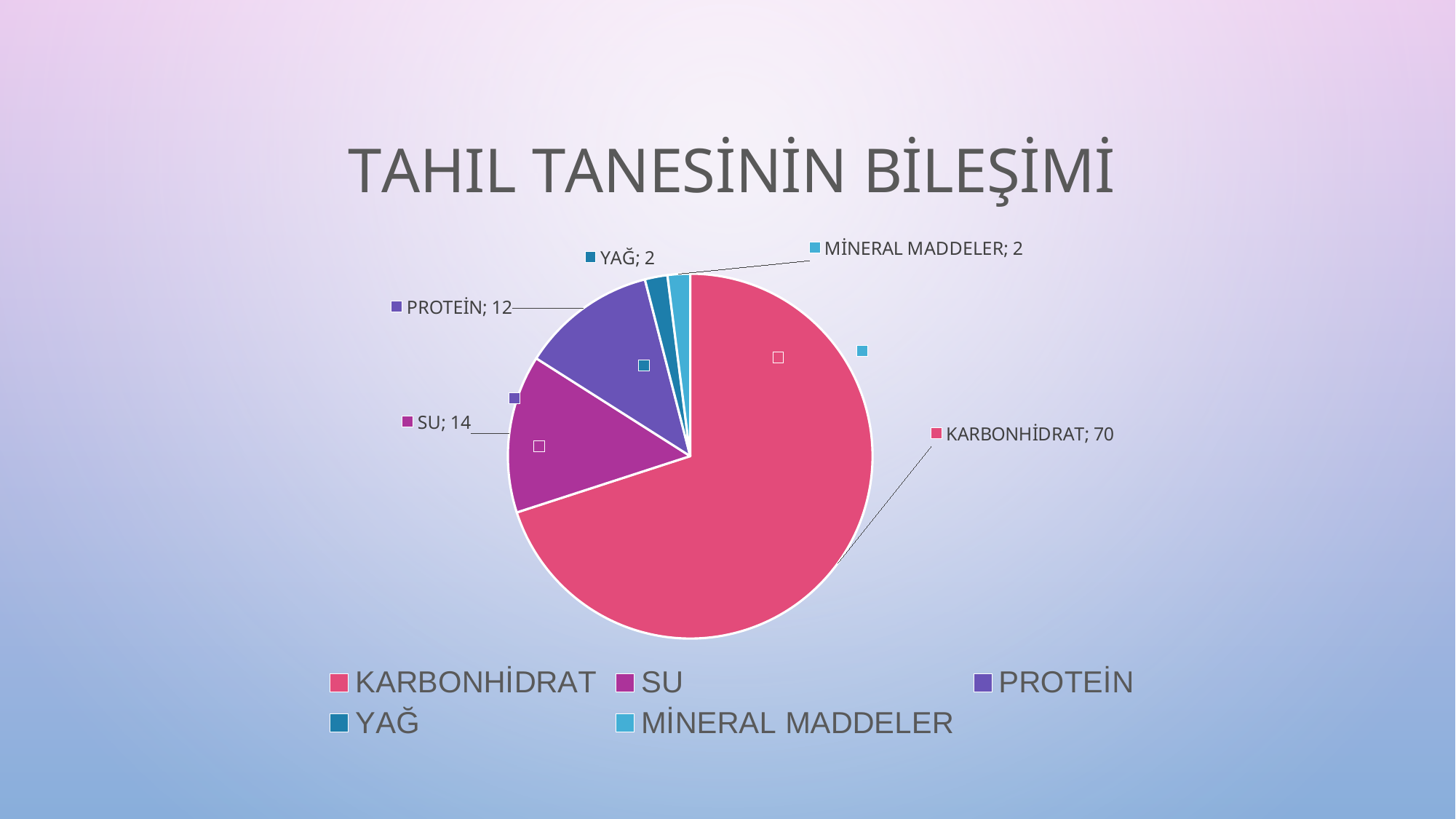
What is the title of the chart? TAHIL TANESİNİN BİLEŞİMİ Which is larger, the value for SU or the value for PROTEİN? SU What is the value for SU? 14 Which category has the largest slice of the pie? KARBONHİDRAT What is the value for MİNERAL MADDELER? 2 What is the value for YAĞ? 2 What is the difference between the values for KARBONHİDRAT and SU? 56 How many categories are shown in the pie chart? 5 What type of chart is shown on the slide? pie chart What is the difference between the values for SU and PROTEİN? 2 What is the value for KARBONHİDRAT? 70 What is the value for PROTEİN? 12